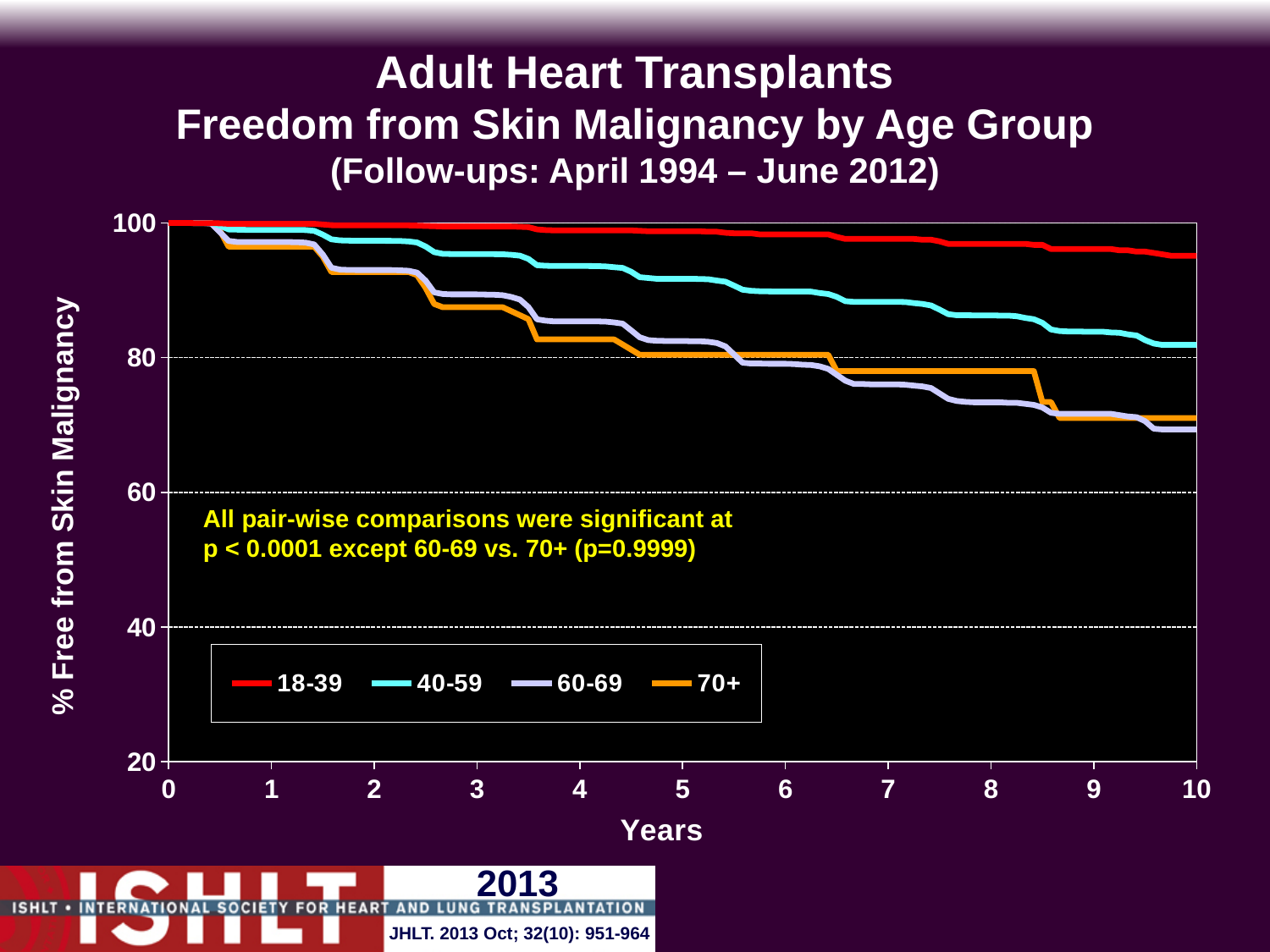
Is the value for the 60-69 group at 10 years greater or less than 80? less What kind of chart is shown on the slide? Line chart How many age groups does the legend list? 4 Which age group has the highest freedom from skin malignancy at 10 years? 18-39 Is the value for the 18-39 group at 10 years greater or less than 80? greater Do the curves rise or fall as years increase? Fall At 5 years, which is larger: the value for the 40-59 group or the 60-69 group? 40-59 Is the value for the 70+ group at 10 years greater or less than 80? less Which age groups are listed in the legend? 18-39, 40-59, 60-69, 70+ At 10 years, which is larger: the value for the 18-39 group or the 70+ group? 18-39 What is the label of the y axis? % Free from Skin Malignancy